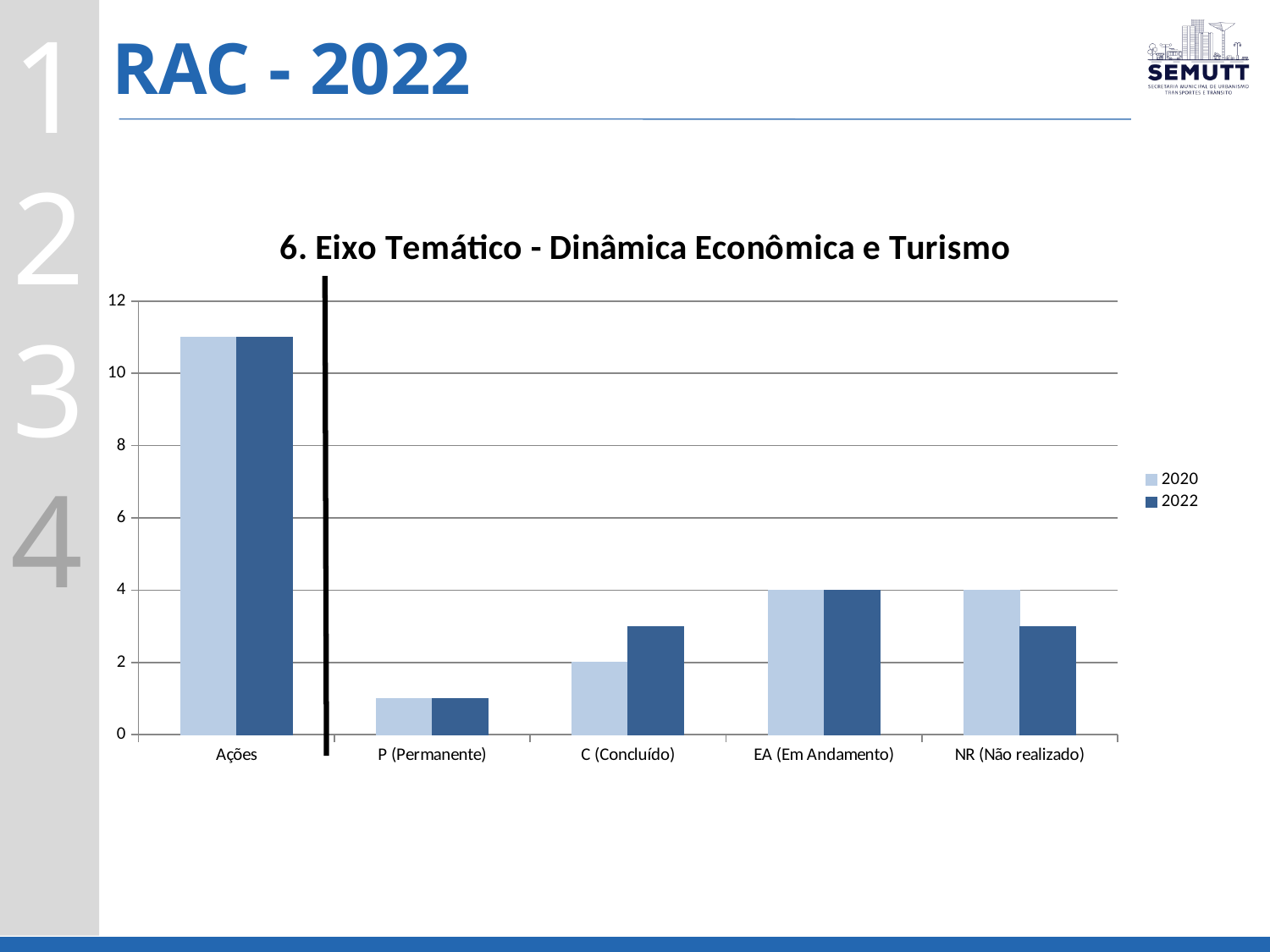
How many categories are shown on the x axis? 5 Which category has the highest value for the 2022 series? Ações How many series does the legend list? 2 Which category has the lowest value for the 2020 series? P (Permanente) Is the 2022 value for NR (Não realizado) greater or less than 4? less What is the 2020 value for C (Concluído)? 2 Is the 2022 value for Ações greater or less than 10? greater What is the title of the chart? 6. Eixo Temático - Dinâmica Econômica e Turismo What type of chart is shown on the slide? bar chart For C (Concluído), which series has the larger value, 2020 or 2022? 2022 What is the 2020 value for EA (Em Andamento)? 4 What is the 2020 value for NR (Não realizado)? 4